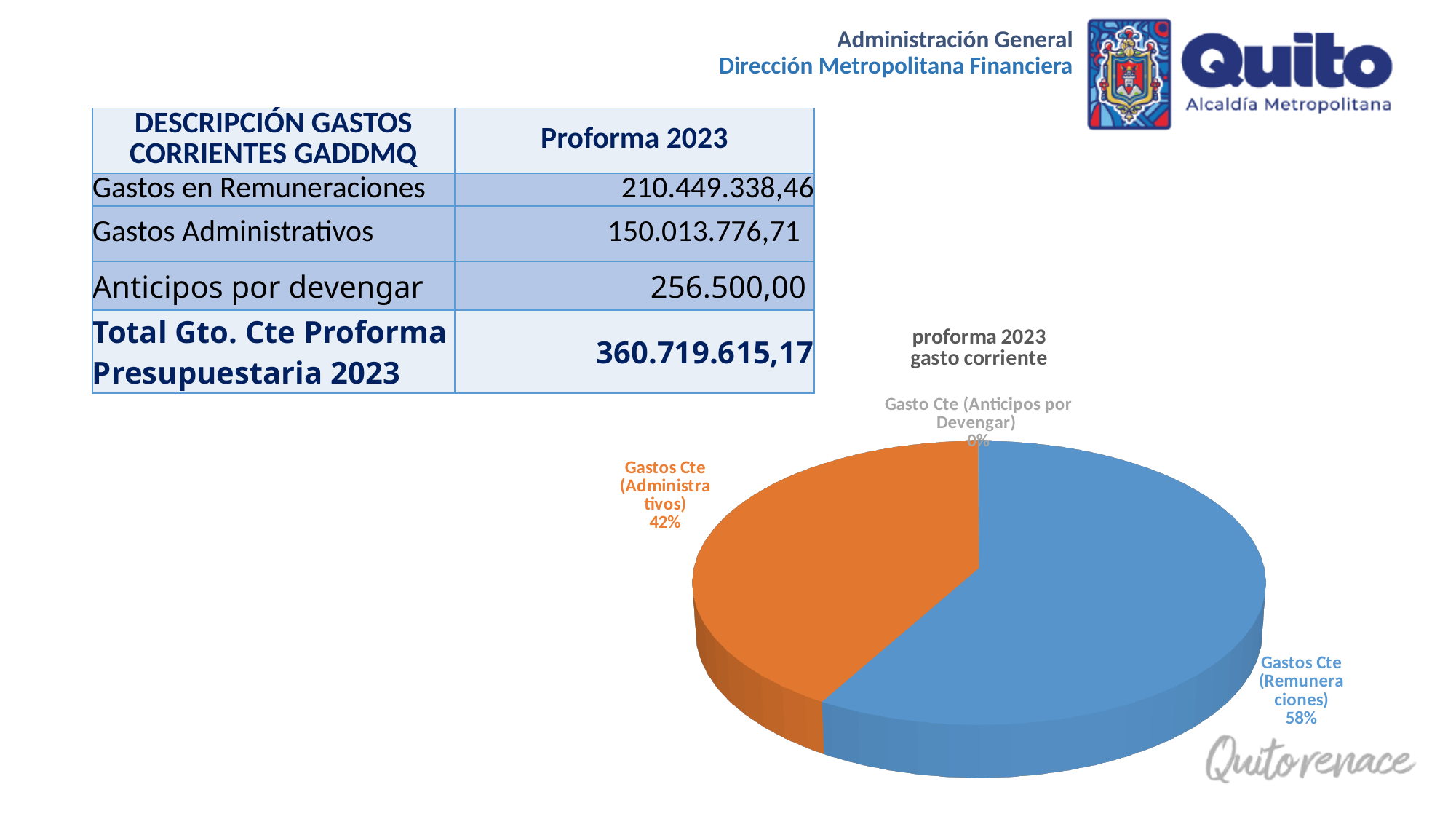
Which is larger in the pie chart, Gastos Cte (Administrativos) or Gastos Cte (Remuneraciones)? Gastos Cte (Remuneraciones) What is the difference in percentage points between the Gastos Cte (Remuneraciones) slice and the Gastos Cte (Administrativos) slice? 16 Which slice of the pie chart is the smallest? Gasto Cte (Anticipos por Devengar) Which slice of the pie chart is the largest? Gastos Cte (Remuneraciones) What share of the pie does Gastos Cte (Remuneraciones) represent? 58% What kind of chart is shown on the slide? pie chart What is the title of the pie chart? proforma 2023 gasto corriente What colour is the Gastos Cte (Administrativos) slice in the pie chart? orange How many slices are labelled in the pie chart? 3 What share of the pie does Gasto Cte (Anticipos por Devengar) represent? 0% What share of the pie does Gastos Cte (Administrativos) represent? 42%